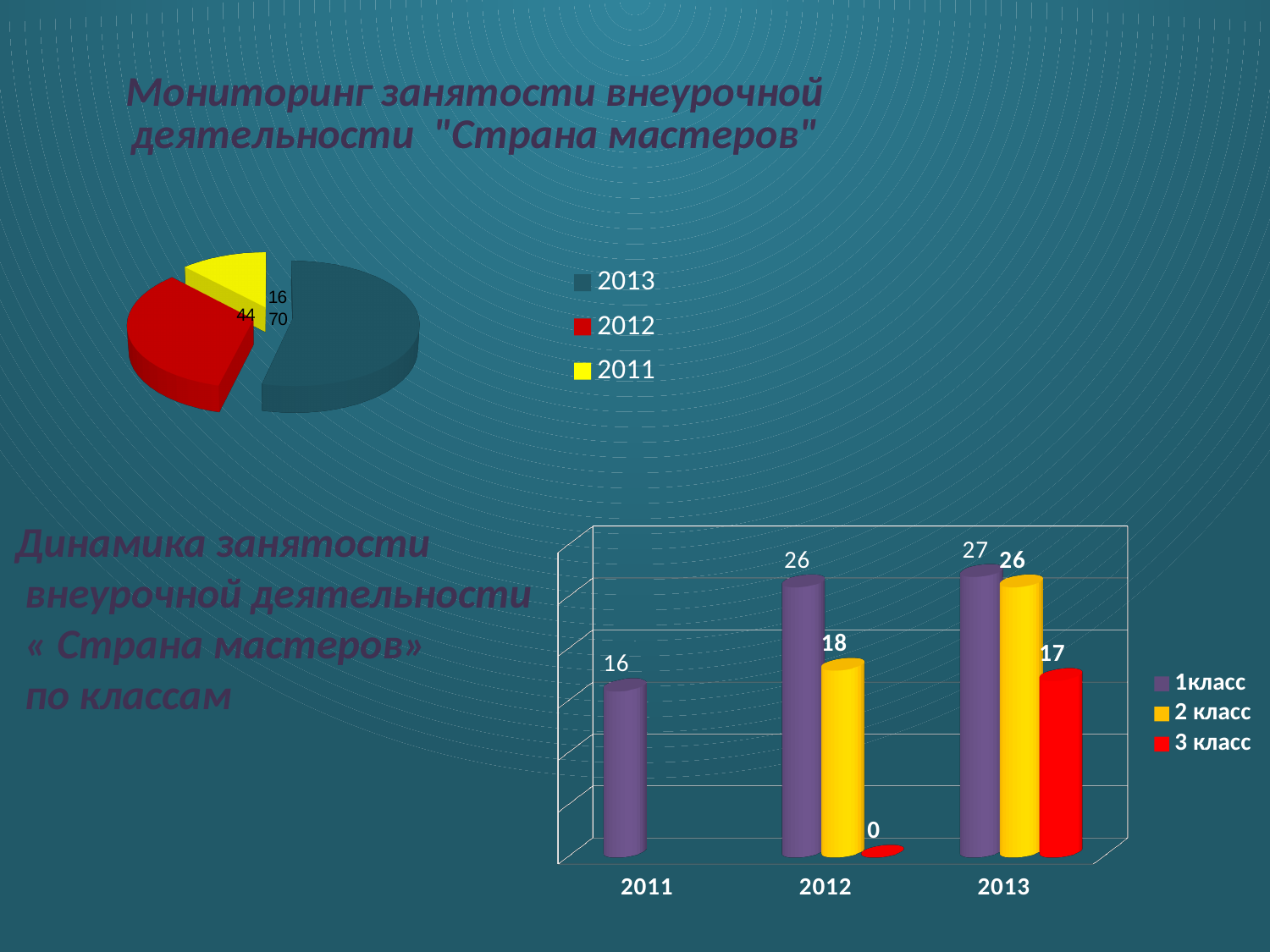
In the bar chart, which year has the highest value for 1класс? 2013 What type of chart is the bottom chart? bar chart How many entries does the legend of the pie chart list? 3 In the pie chart, what is the difference between the values for 2013 and 2012? 26 In the pie chart, what is the value for 2013? 70 In the bar chart, what is the value for 3 класс in 2013? 17 In the bar chart, what is the value for 1класс in 2012? 26 In the pie chart, which year has the largest slice? 2013 In the bar chart, what is the difference between 2 класс in 2013 and 2 класс in 2012? 8 In the bar chart, what is the value for 3 класс in 2012? 0 In the bar chart, does the value for 1класс rise or fall from 2011 to 2013? rise In the pie chart, what is the value for 2011? 16